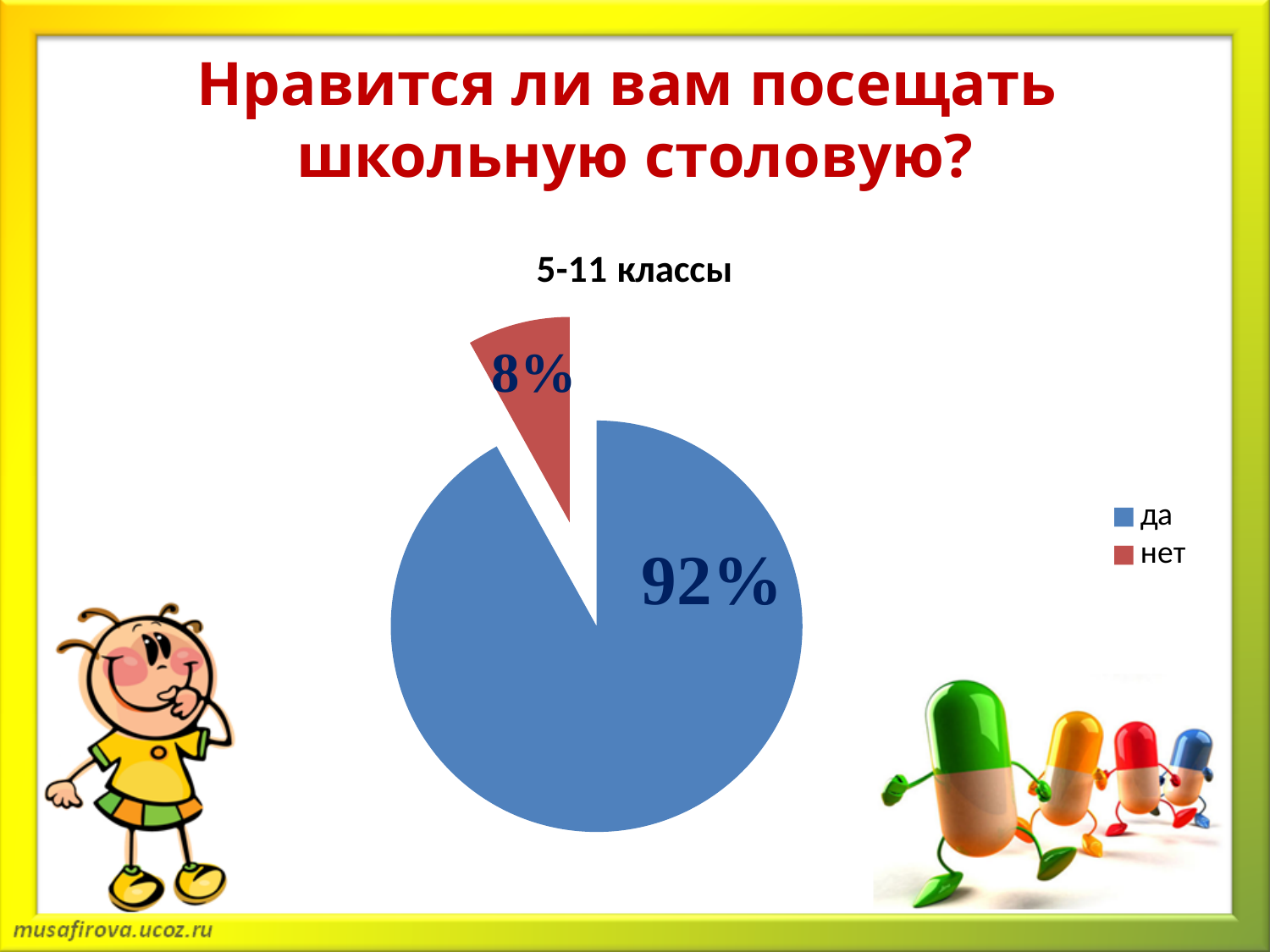
Which slice is the largest? да What colour is the "нет" slice? red Which slice is the smallest? нет What is the difference between the "да" and "нет" shares? 84% What is the chart's title? 5-11 классы How many slices does the pie chart have? 2 Which is larger, the "да" slice or the "нет" slice? да How many entries does the legend list? 2 What kind of chart is shown on the slide? pie chart What share of the pie does the "нет" slice take? 8% What share of the pie does the "да" slice take? 92%